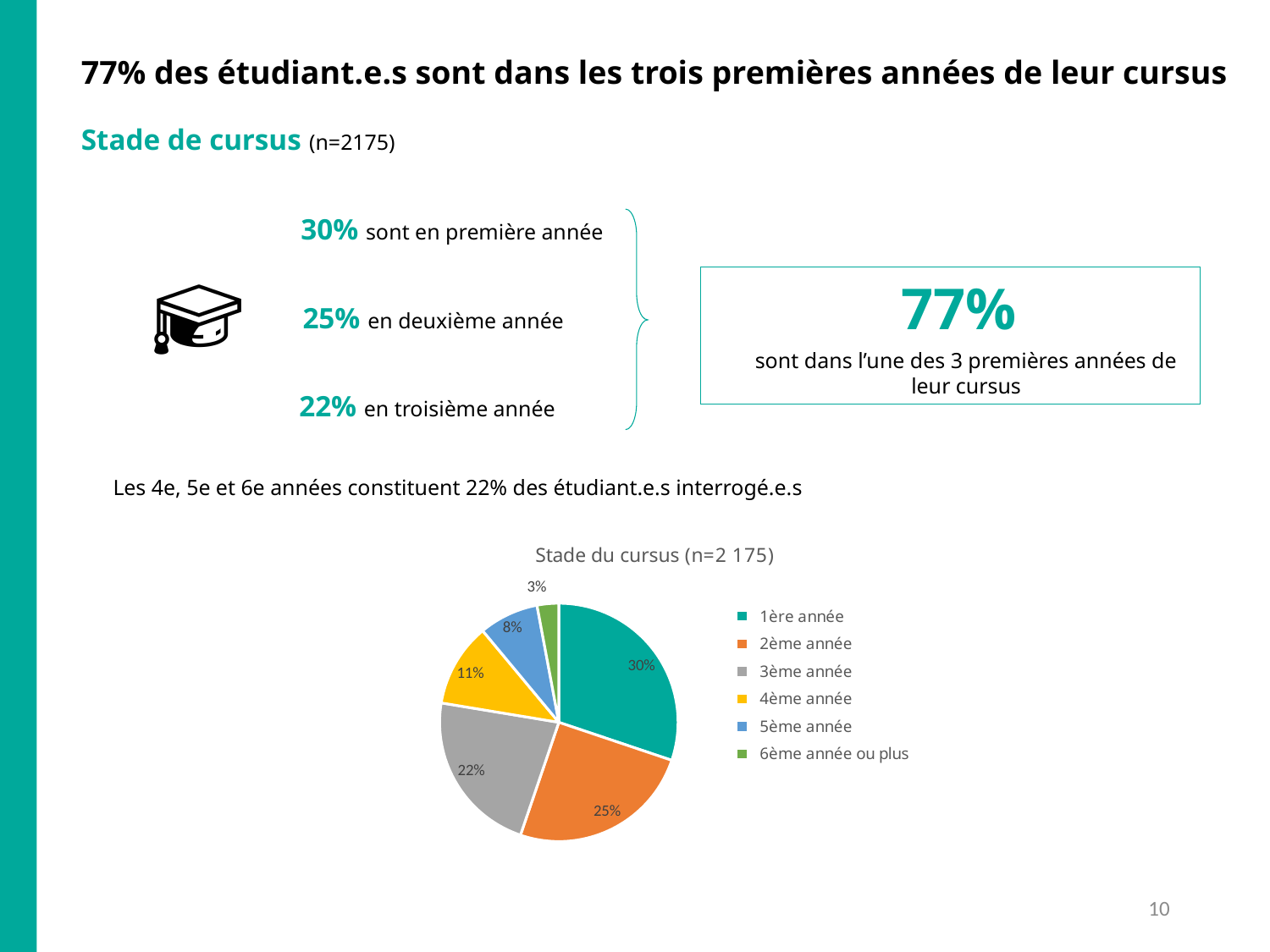
What share of the pie is 1ère année? 30% What share of the pie is 5ème année? 8% What is the difference in percentage points between 1ère année and 3ème année? 8 What share of the pie is 6ème année ou plus? 3% What kind of chart is shown on the slide? pie chart What share of the pie is 2ème année? 25% Which category has the smallest slice of the pie? 6ème année ou plus What is the title of the chart? Stade du cursus (n=2 175) Which category has the largest slice of the pie? 1ère année What share of the pie is 4ème année? 11% What share of the pie is 3ème année? 22% How many categories does the legend list? 6